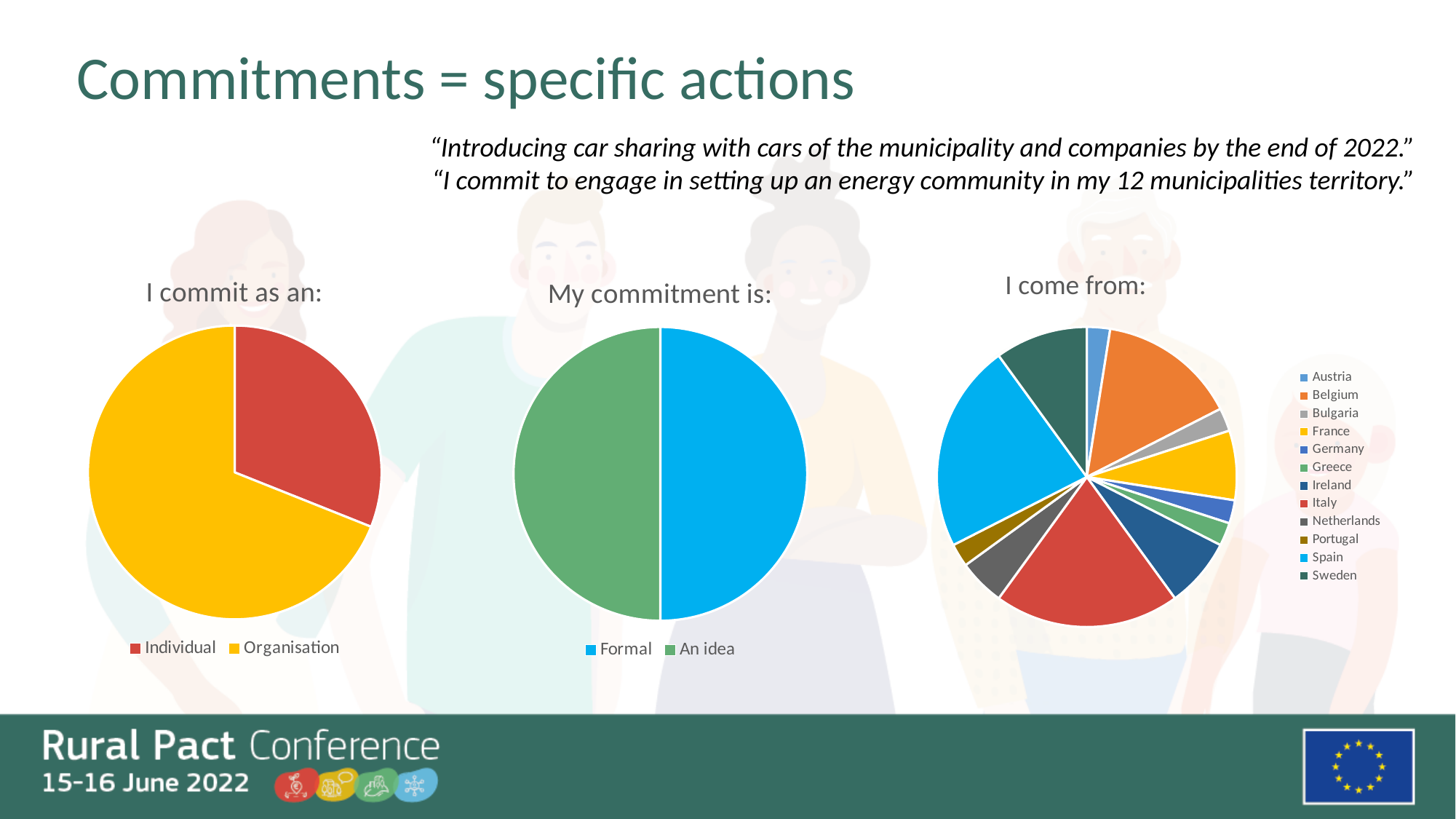
What kind of chart is 'I come from:'? Pie chart In the 'I come from:' chart, which slice is larger, Italy or Germany? Italy In the 'I come from:' chart, which slice is larger, Sweden or Austria? Sweden How many categories does the 'My commitment is:' pie chart show? 2 What kind of chart is used for 'I commit as an:'? Pie chart How many categories does the 'I commit as an:' pie chart show? 2 In the 'I come from:' chart, which slice is larger, Belgium or Bulgaria? Belgium What are the two legend entries of the 'My commitment is:' chart? Formal and An idea In the 'I commit as an:' chart, which colour represents Individual? Red How many countries are listed in the legend of the 'I come from:' chart? 12